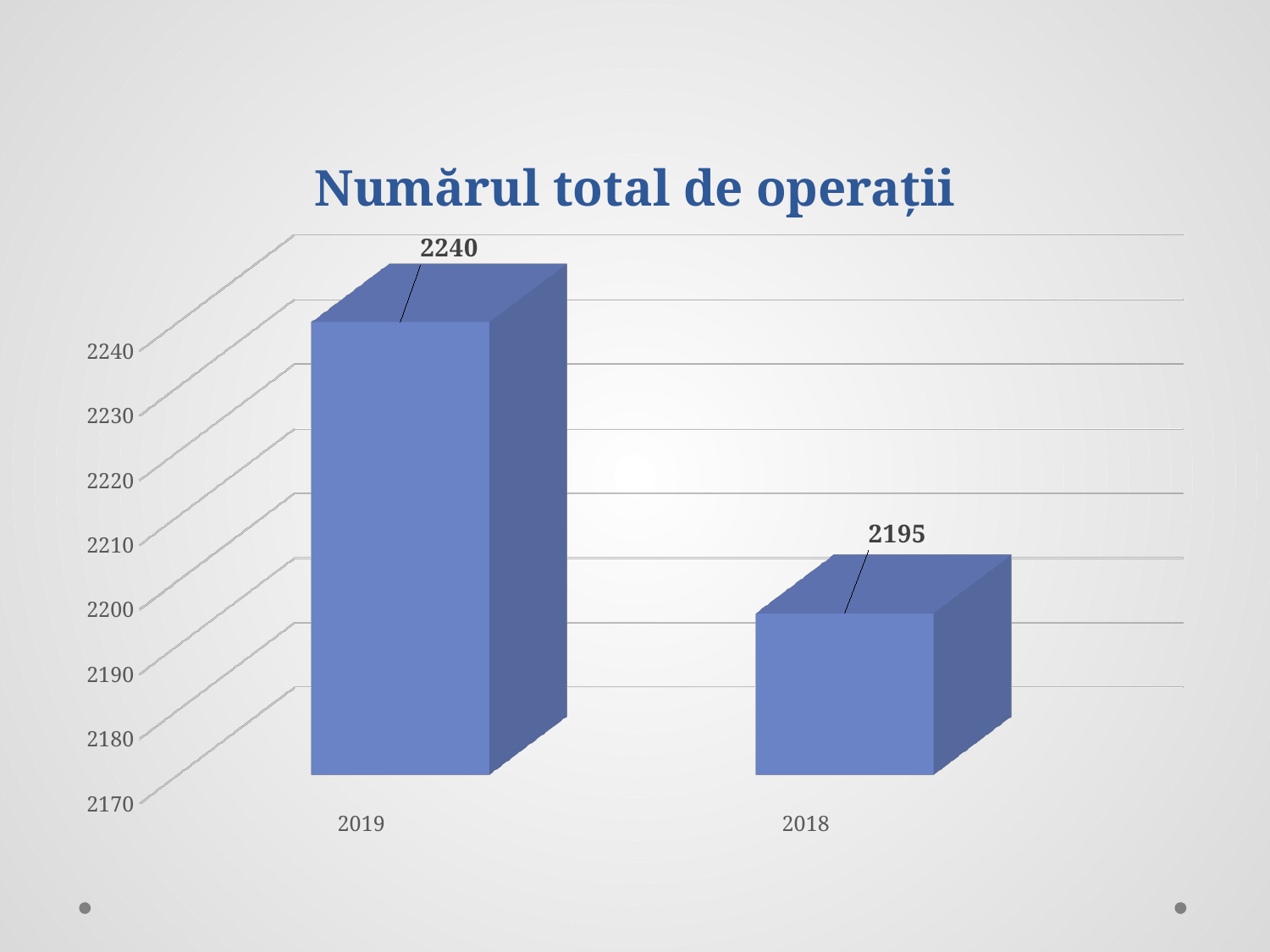
What is the title of the chart? Numărul total de operații Which year has the lowest value? 2018 What is the difference between the values for 2019 and 2018? 45 Which is larger, the value for 2019 or the value for 2018? 2019 Do the values rise or fall from left to right along the x axis? fall Which year has the highest value? 2019 What kind of chart is shown on the slide? bar chart Is the value for 2018 greater or less than 2200? less What is the value for 2018? 2195 How many categories are shown on the x axis? 2 Is the value for 2019 greater or less than 2230? greater What is the value for 2019? 2240